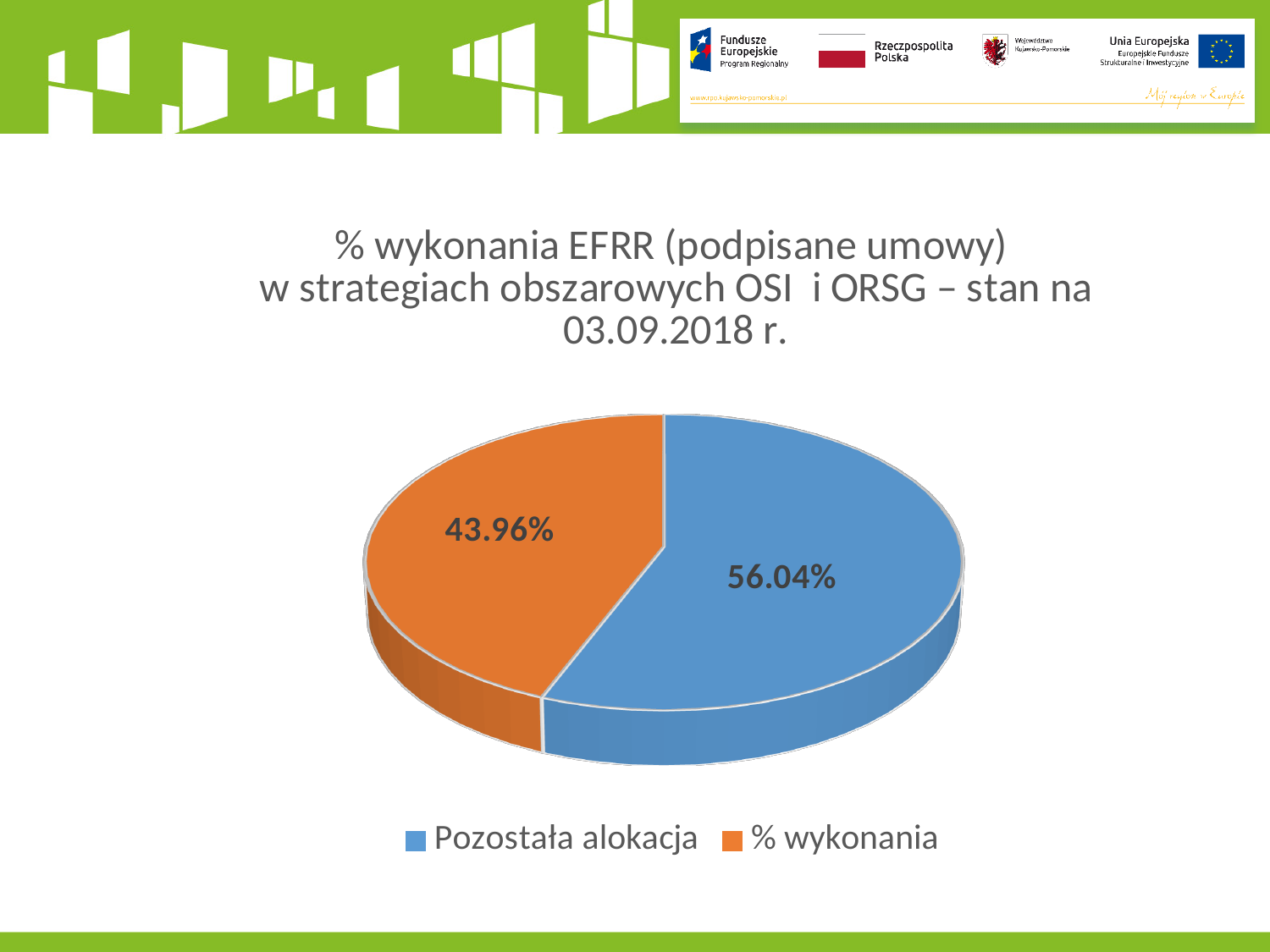
How many slices does the pie chart have? 2 What share of the pie does "% wykonania" represent? 43.96% Which slice is the largest? Pozostała alokacja How many entries does the legend list? 2 What colour is the "Pozostała alokacja" slice? blue Which slice is the smallest? % wykonania What kind of chart is shown on the slide? pie chart What date is given in the chart title as the status date? 03.09.2018 r. What is the value for "Pozostała alokacja"? 56.04% What is the value for "% wykonania"? 43.96% What is the difference between the "Pozostała alokacja" and "% wykonania" slices? 12.08% Which is larger, "Pozostała alokacja" or "% wykonania"? Pozostała alokacja